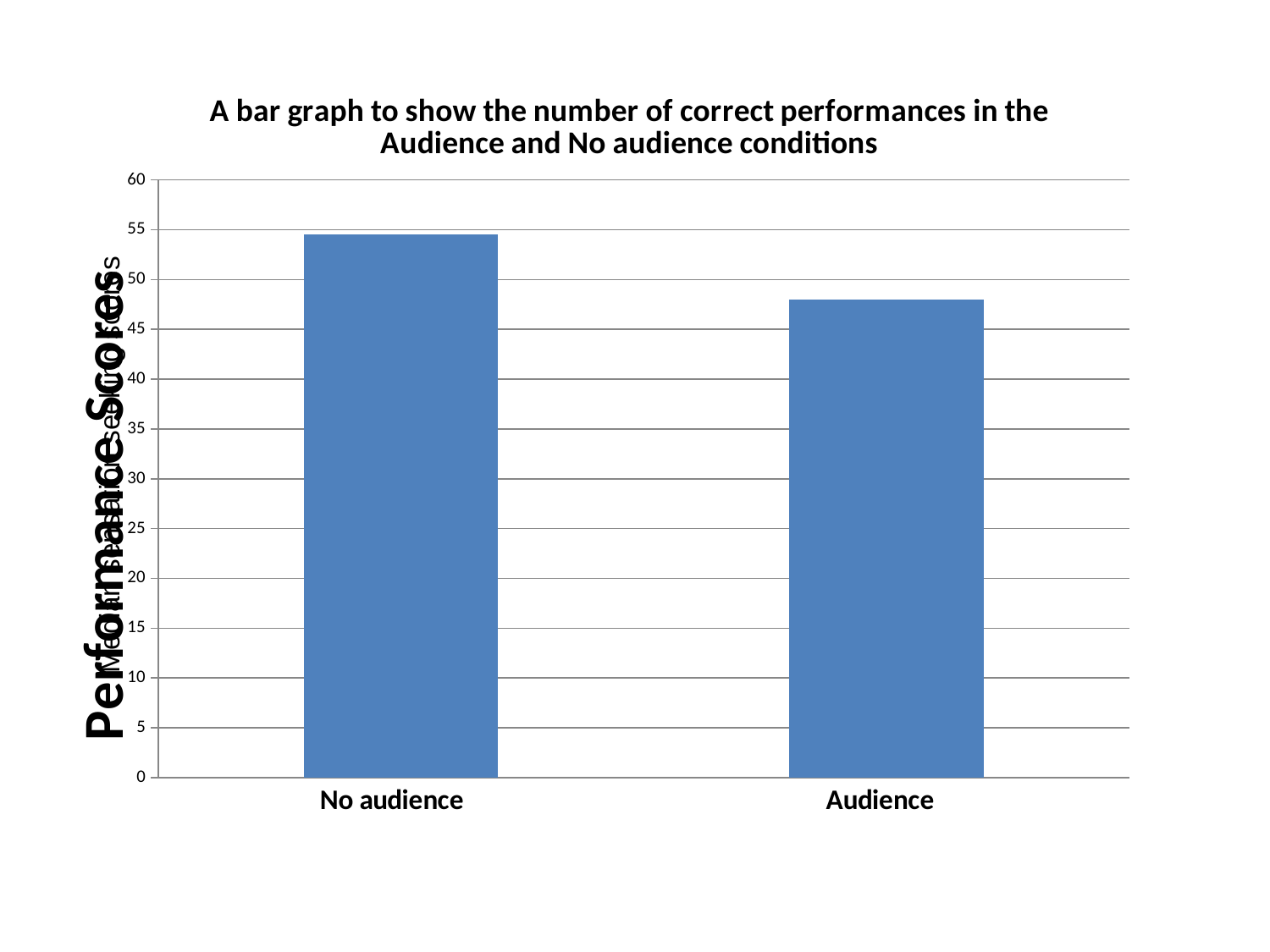
Do the bar values rise or fall from No audience to Audience along the x axis? fall Which condition has the lowest bar in the chart? Audience Is the value for Audience greater or less than 45? greater How many categories are shown on the x axis of the chart? 2 Which condition has the highest bar in the chart? No audience What kind of chart is shown on the slide? bar chart Is the value for Audience greater or less than 50? less What is the title of the chart? A bar graph to show the number of correct performances in the Audience and No audience conditions Which bar is taller, No audience or Audience? No audience What is the highest value shown on the y axis of the chart? 60 Is the value for No audience greater or less than 40? greater